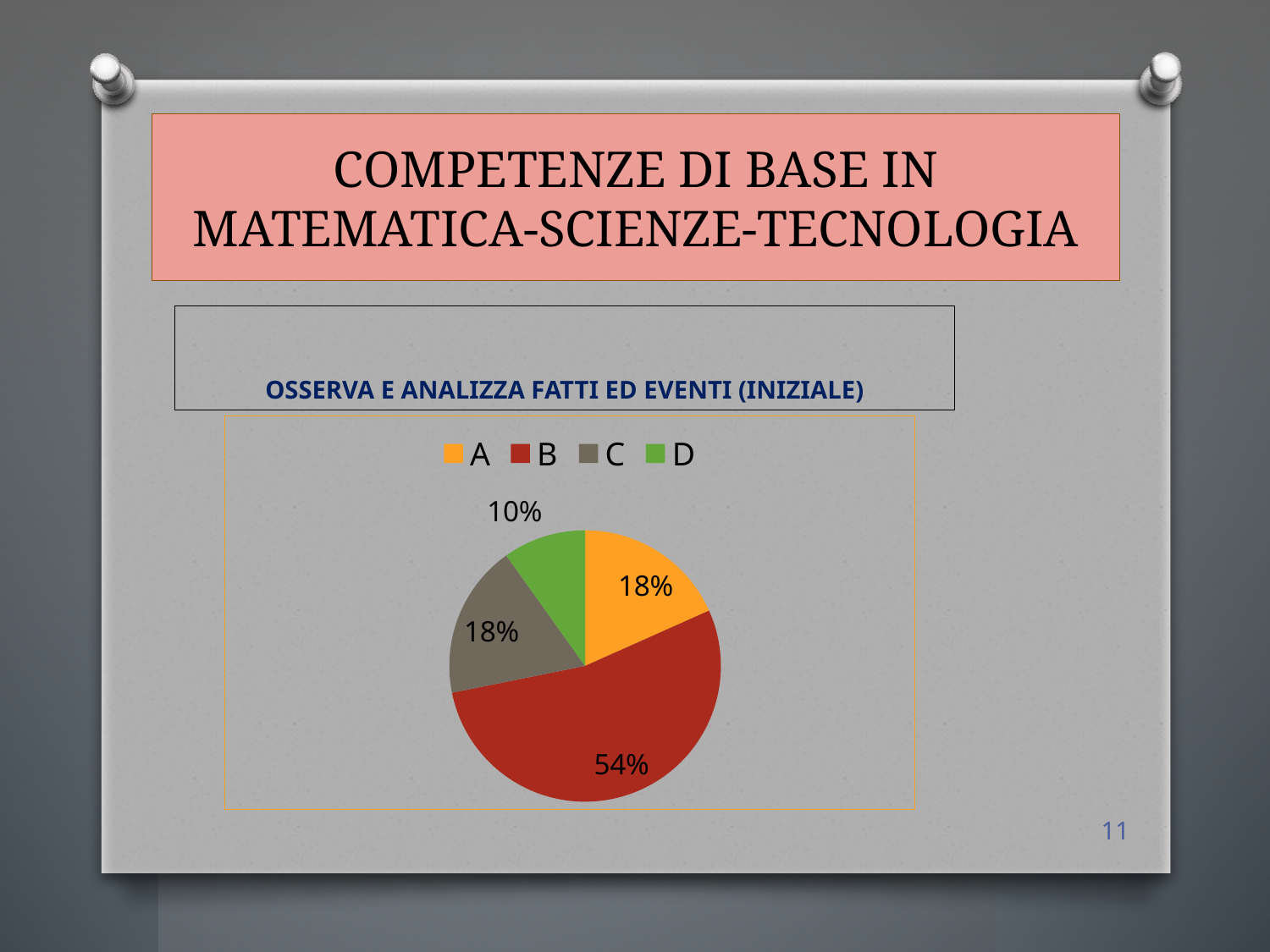
What is the difference between the shares of category B and category D? 44% What colour is the slice for category B? red What share of the pie does category A have? 18% What share of the pie does category C have? 18% Which category has the smallest slice of the pie? D What share of the pie does category B have? 54% What is the title shown above the pie chart? OSSERVA E ANALIZZA FATTI ED EVENTI (INIZIALE) How many categories does the legend list? 4 Which category has the largest slice of the pie? B What type of chart is shown on the slide? pie chart What share of the pie does category D have? 10% Which is larger, the share of category B or the share of category A? B